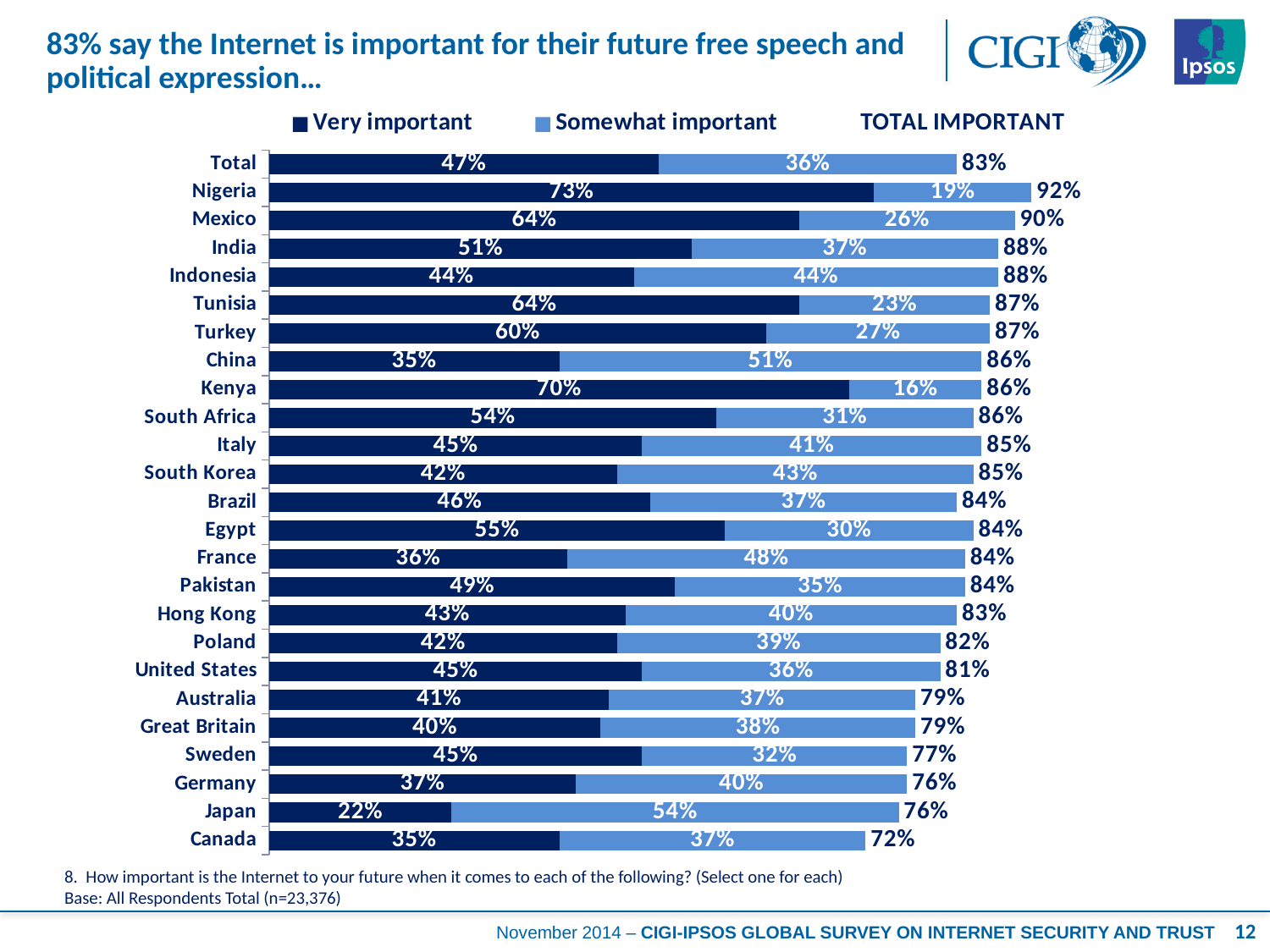
What kind of chart is shown on the slide? Stacked bar chart What percentage of respondents in Nigeria say the Internet is "Very important" for their future free speech and political expression? 73% What is the total of the stacked bar for Germany? 76% Which country has the highest TOTAL IMPORTANT value? Nigeria How many categories (rows) are shown in the chart? 25 Which country has the lowest "Very important" value? Japan What is the "Somewhat important" value for Japan? 54% How many series does the legend list? 3 Which has a larger "Somewhat important" value, France or Egypt? France What is the difference between the "Very important" values for Kenya and China? 35% What is the TOTAL IMPORTANT value for Canada? 72% Which series is shown in the dark blue colour? Very important